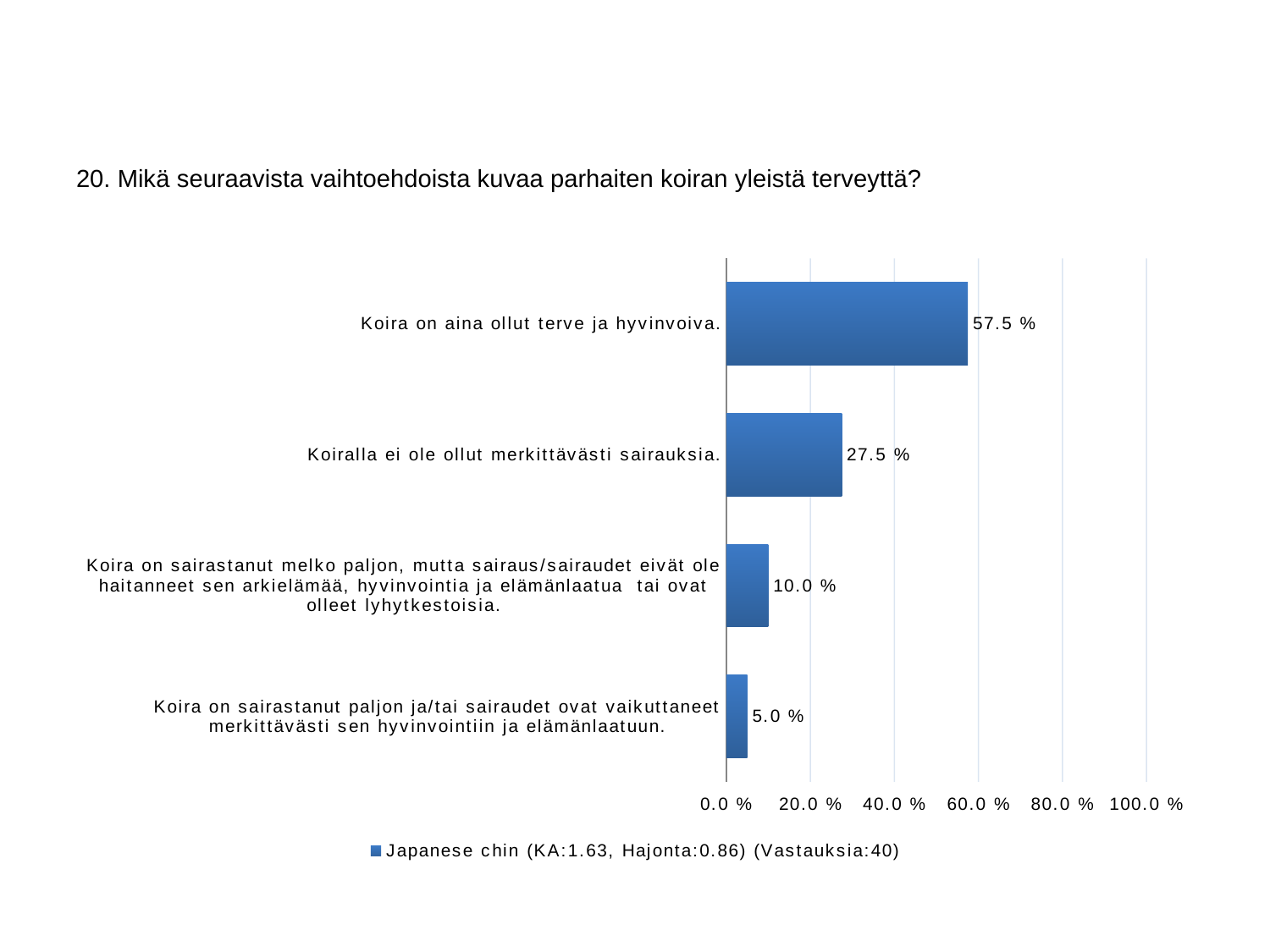
How many categories are shown in the chart? 4 Is the value for "Koira on aina ollut terve ja hyvinvoiva." greater or less than 40.0 %? greater Which category has the lowest value? Koira on sairastanut paljon ja/tai sairaudet ovat vaikuttaneet merkittävästi sen hyvinvointiin ja elämänlaatuun. What is the value for "Koiralla ei ole ollut merkittävästi sairauksia."? 27.5 % What type of chart is shown on the slide? Bar chart What is the difference between the values for "Koira on aina ollut terve ja hyvinvoiva." and "Koiralla ei ole ollut merkittävästi sairauksia."? 30.0 % What is the value for "Koira on aina ollut terve ja hyvinvoiva."? 57.5 % What is the value for "Koira on sairastanut paljon ja/tai sairaudet ovat vaikuttaneet merkittävästi sen hyvinvointiin ja elämänlaatuun."? 5.0 % How many series does the legend list? 1 Which category has the highest value? Koira on aina ollut terve ja hyvinvoiva. What is the legend entry for the series? Japanese chin (KA:1.63, Hajonta:0.86) (Vastauksia:40) Which is larger: the value for "Koiralla ei ole ollut merkittävästi sairauksia." or the value for the category starting "Koira on sairastanut melko paljon"? Koiralla ei ole ollut merkittävästi sairauksia.